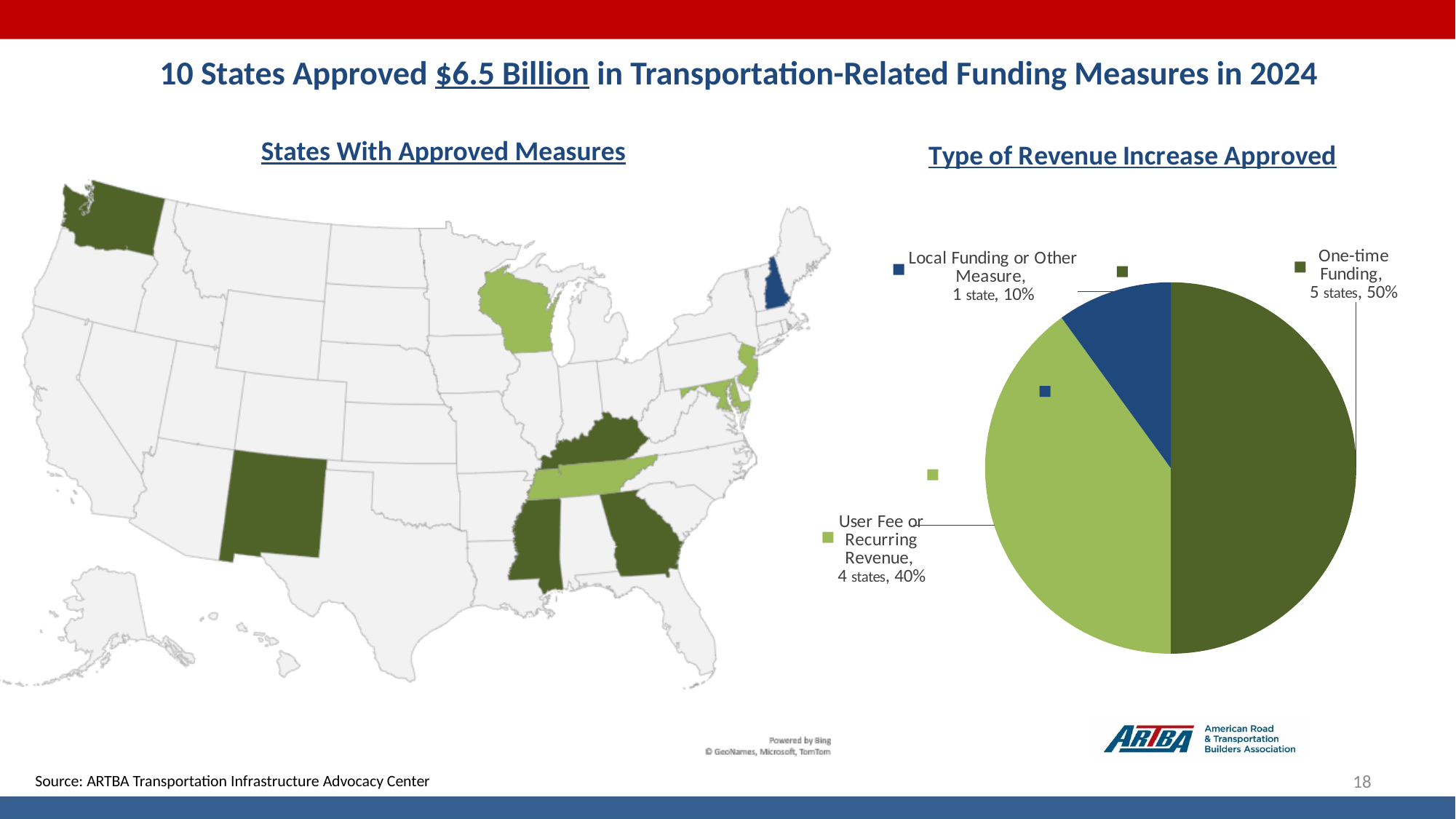
In the 'Type of Revenue Increase Approved' chart, how many states approved a User Fee or Recurring Revenue measure? 4 states How many categories are shown in the 'Type of Revenue Increase Approved' chart? 3 In the 'Type of Revenue Increase Approved' chart, which category has the smallest slice? Local Funding or Other Measure In the 'Type of Revenue Increase Approved' chart, what share of the pie is One-time Funding? 50% What kind of chart is 'Type of Revenue Increase Approved'? Pie chart In the 'Type of Revenue Increase Approved' chart, what colour is the Local Funding or Other Measure slice? Dark blue In the 'Type of Revenue Increase Approved' chart, what percentage is shown for Local Funding or Other Measure? 10% In the 'Type of Revenue Increase Approved' chart, which is larger: the share for User Fee or Recurring Revenue or the share for Local Funding or Other Measure? User Fee or Recurring Revenue In the 'Type of Revenue Increase Approved' chart, what is the total number of states across all three categories? 10 In the 'Type of Revenue Increase Approved' chart, how many more states approved One-time Funding than Local Funding or Other Measure? 4 In the 'Type of Revenue Increase Approved' chart, which category has the largest slice? One-time Funding What kind of chart is 'States With Approved Measures'? Map chart